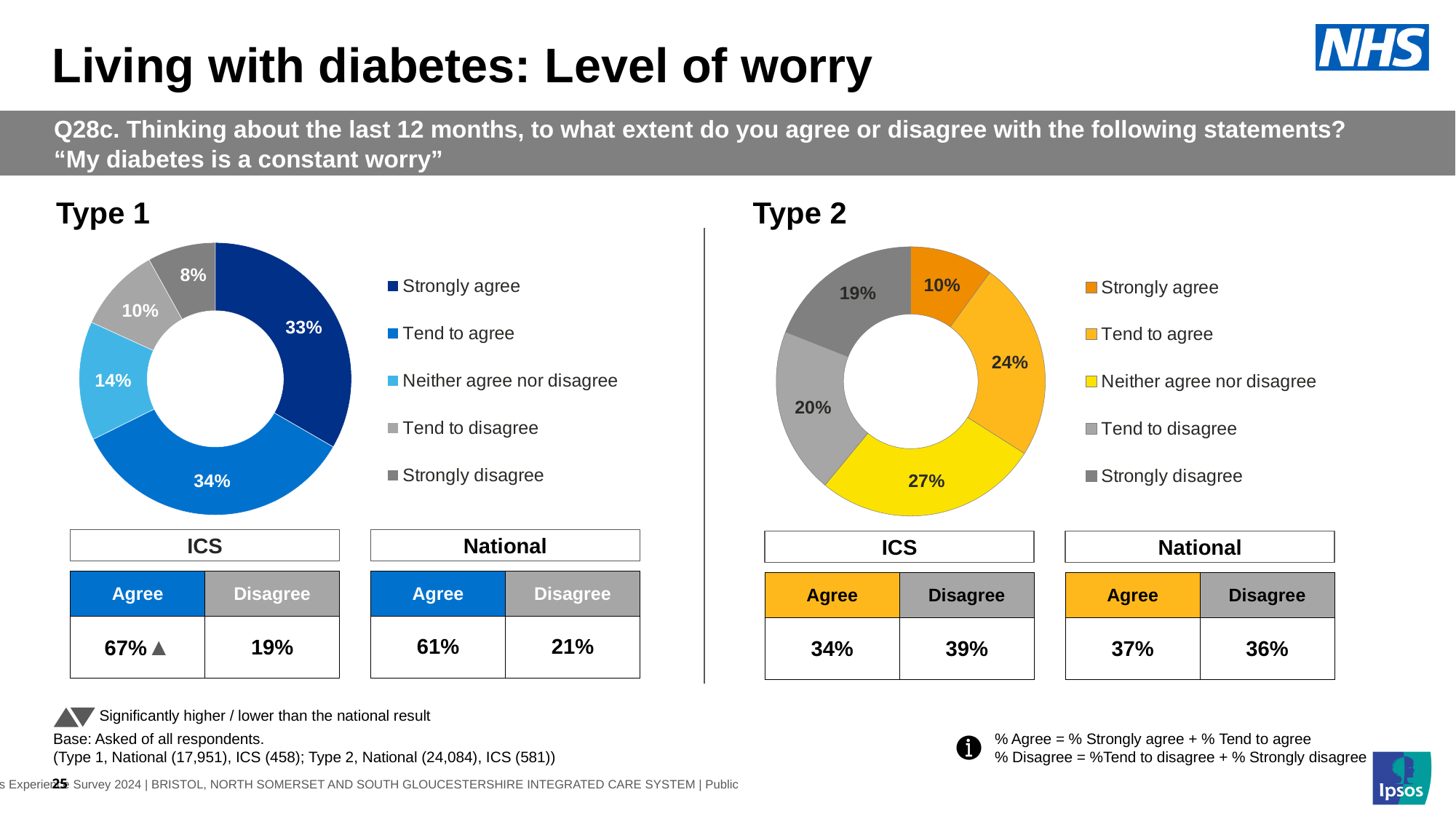
What kind of chart is used for Type 2? Donut (pie) chart In the Type 2 chart, which response category has the smallest share? Strongly agree In the Type 1 chart, what is the difference between the Tend to agree and Neither agree nor disagree shares? 20% What colour represents Strongly agree in the Type 2 chart? Orange How many response categories does the legend of the Type 1 chart list? 5 In the Type 2 chart, which response category has the largest share? Neither agree nor disagree In the Type 2 chart, which is larger: Tend to agree or Tend to disagree? Tend to agree In the Type 1 chart, what percentage of respondents strongly agree? 33% In the Type 2 chart, what percentage of respondents strongly disagree? 19% In the Type 1 chart, what percentage of respondents tend to disagree? 10% In the Type 2 chart, what percentage of respondents neither agree nor disagree? 27% In the Type 1 chart, which response category has the smallest share? Strongly disagree